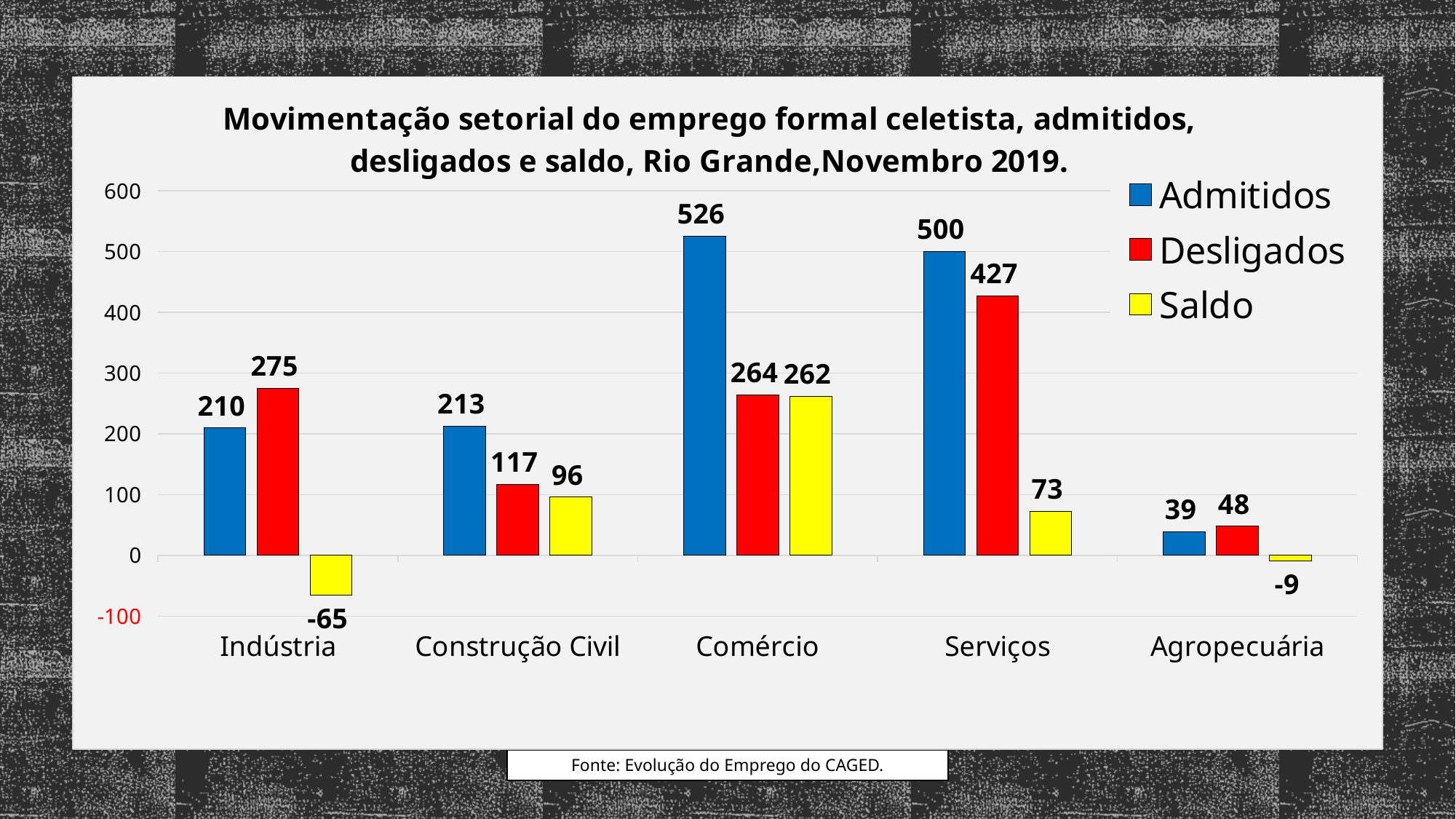
Which is larger for Indústria, Admitidos or Desligados? Desligados How many sectors are shown on the x axis? 5 Is the Desligados value for Serviços greater or less than 400? greater What is the Desligados value for Serviços? 427 What is the Admitidos value for Comércio? 526 Which sector has the lowest Desligados value? Agropecuária What is the Saldo value for Indústria? -65 What kind of chart is shown on the slide? bar chart How many series does the legend list? 3 Which sector has the highest Admitidos value? Comércio What is the difference between Admitidos and Desligados for Construção Civil? 96 What colour represents the Saldo series? yellow